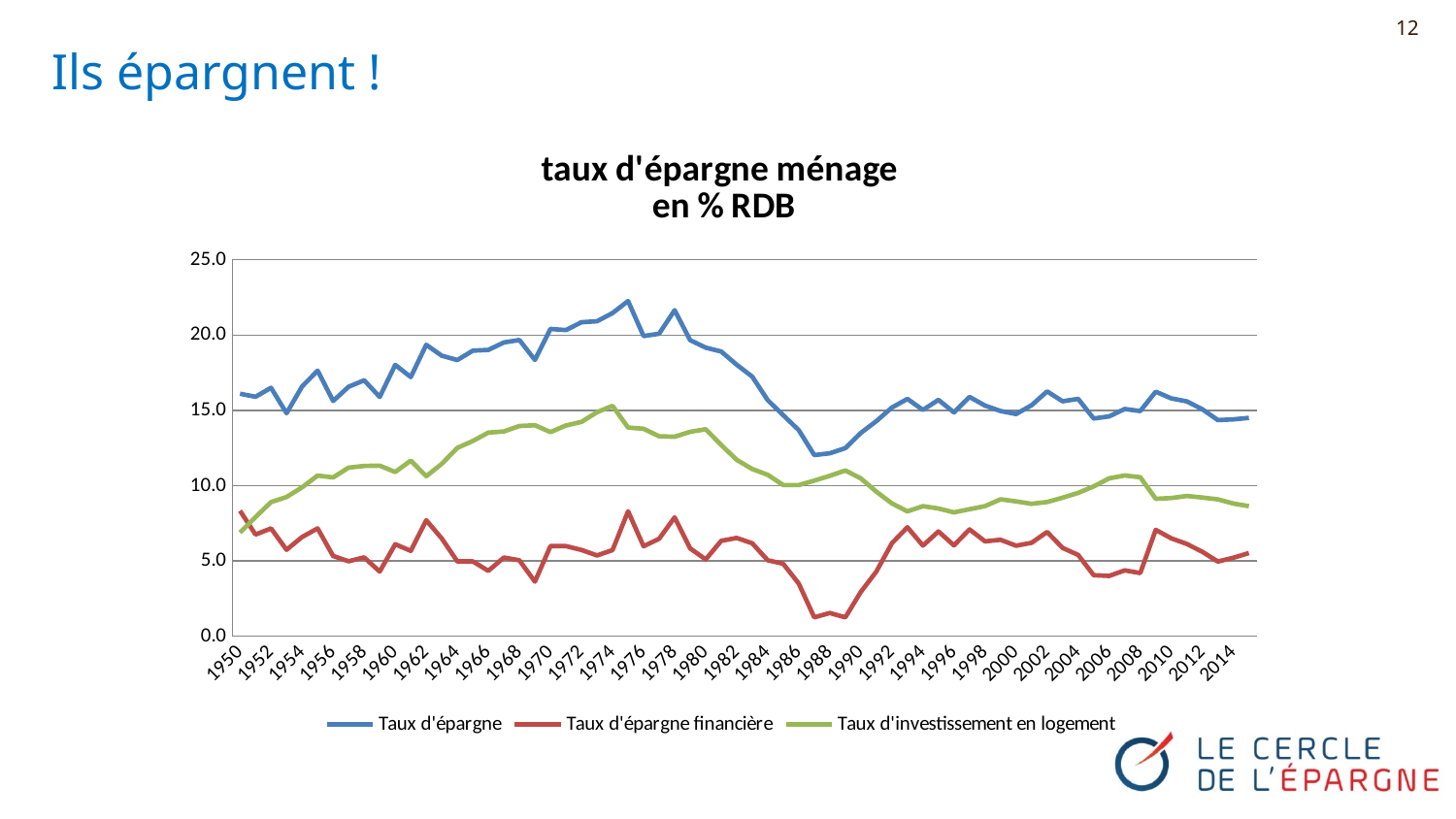
In 1988, which is larger: Taux d'investissement en logement or Taux d'épargne financière? Taux d'investissement en logement What kind of chart is shown on the slide? line chart How many series does the legend list? 3 Does the Taux d'épargne financière line rise or fall between 1988 and 1993? rise Does the Taux d'épargne line rise or fall between 1975 and 1988? fall What is the title of the chart? taux d'épargne ménage en % RDB Is the value for Taux d'épargne in 1950 greater or less than 15.0? greater Is the value for Taux d'épargne financière in 1988 greater or less than 5.0? less Is the value for Taux d'investissement en logement in 2014 greater or less than 10.0? less Which colour is used for the Taux d'épargne line? blue